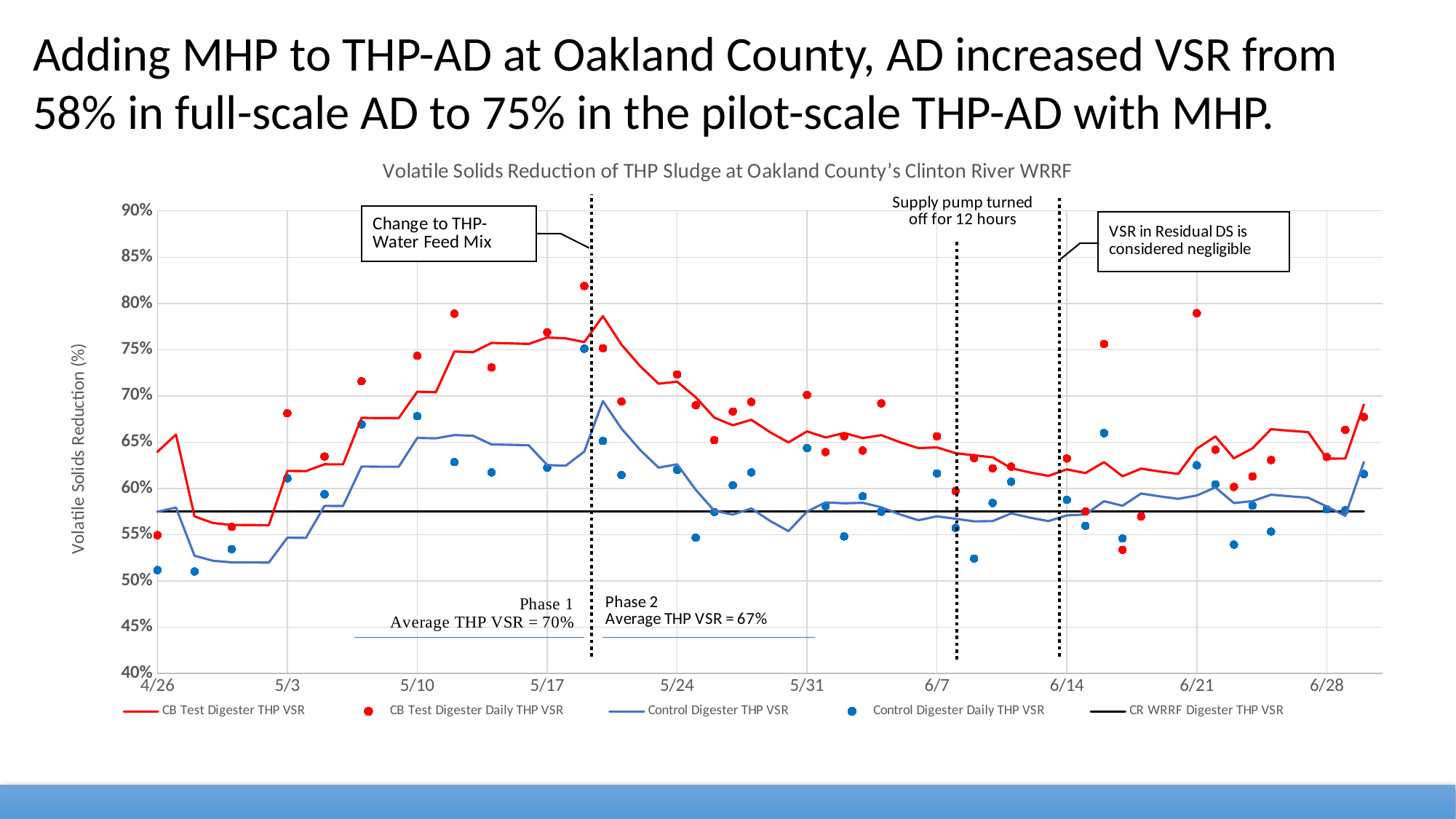
Is the CB Test Digester THP VSR line at 5/17 greater or less than 70%? greater What is the title of the chart? Volatile Solids Reduction of THP Sludge at Oakland County's Clinton River WRRF At 5/17, which is higher: the CB Test Digester THP VSR line or the Control Digester THP VSR line? CB Test Digester THP VSR Does the CB Test Digester THP VSR line rise or fall between 5/3 and 5/17? rise By how much does the Phase 1 average THP VSR exceed the Phase 2 average THP VSR? 3 percentage points Is the CR WRRF Digester THP VSR line greater or less than 60%? less What is the Phase 2 average THP VSR stated on the chart? 67% Is the Control Digester THP VSR line at 4/26 greater or less than 65%? less How many date labels are shown on the x axis? 10 What is the Phase 1 average THP VSR stated on the chart? 70% How many series does the chart legend list? 5 What kind of chart is shown on the slide? Line chart with scatter points